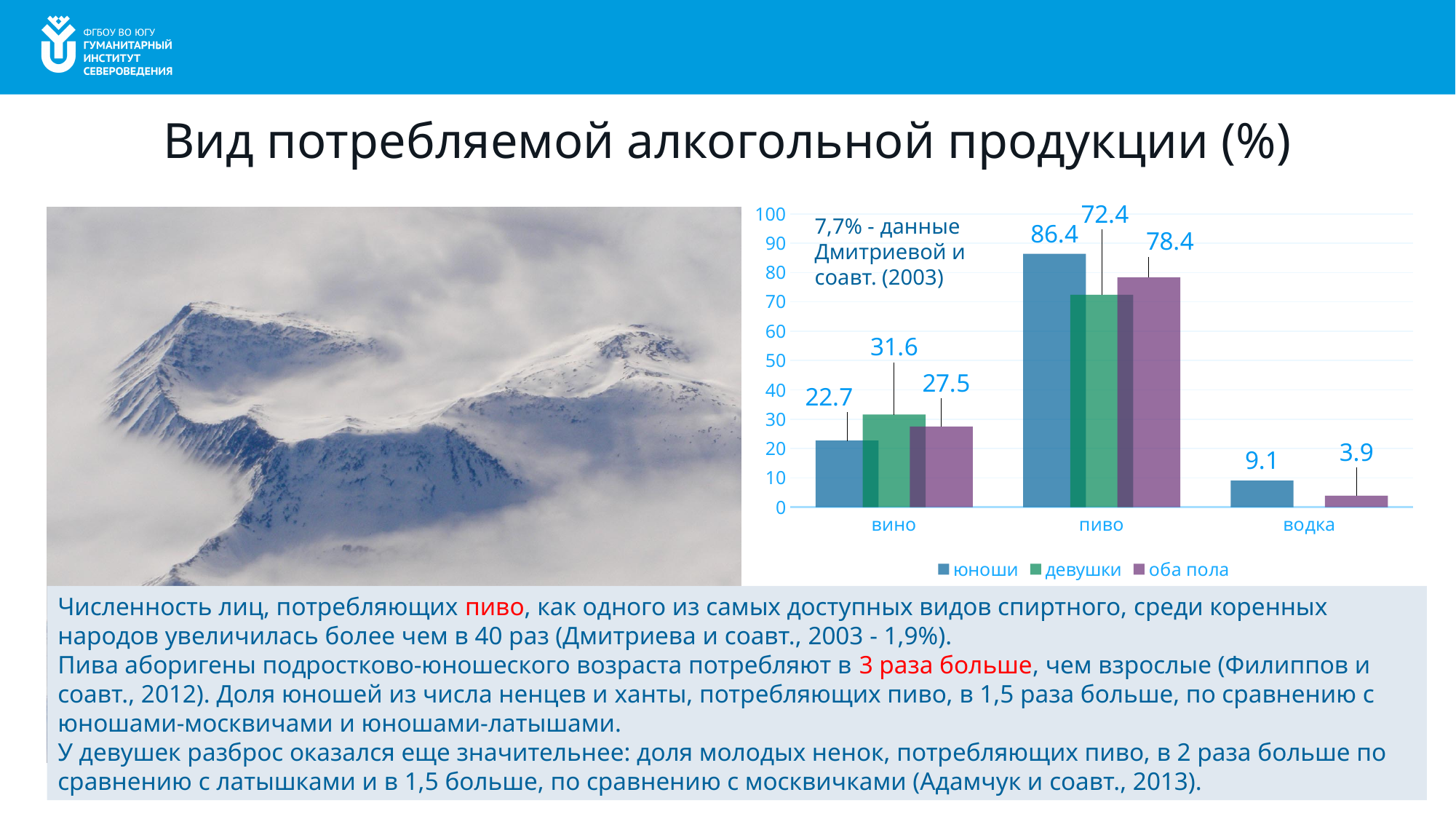
What is the value for оба пола in the водка category? 3.9 What type of chart is shown on the slide? bar chart What is the difference between the юноши and девушки values in the пиво category? 14 In the вино category, which is larger: the value for юноши or for девушки? девушки Which category has the lowest value for оба пола? водка What is the title of the slide containing the chart? Вид потребляемой алкогольной продукции (%) How many series does the legend list? 3 What is the value for девушки in the пиво category? 72.4 What is the value for юноши in the вино category? 22.7 How many categories are shown on the x axis? 3 Which category has the highest value for юноши? пиво What is the value for оба пола in the вино category? 27.5